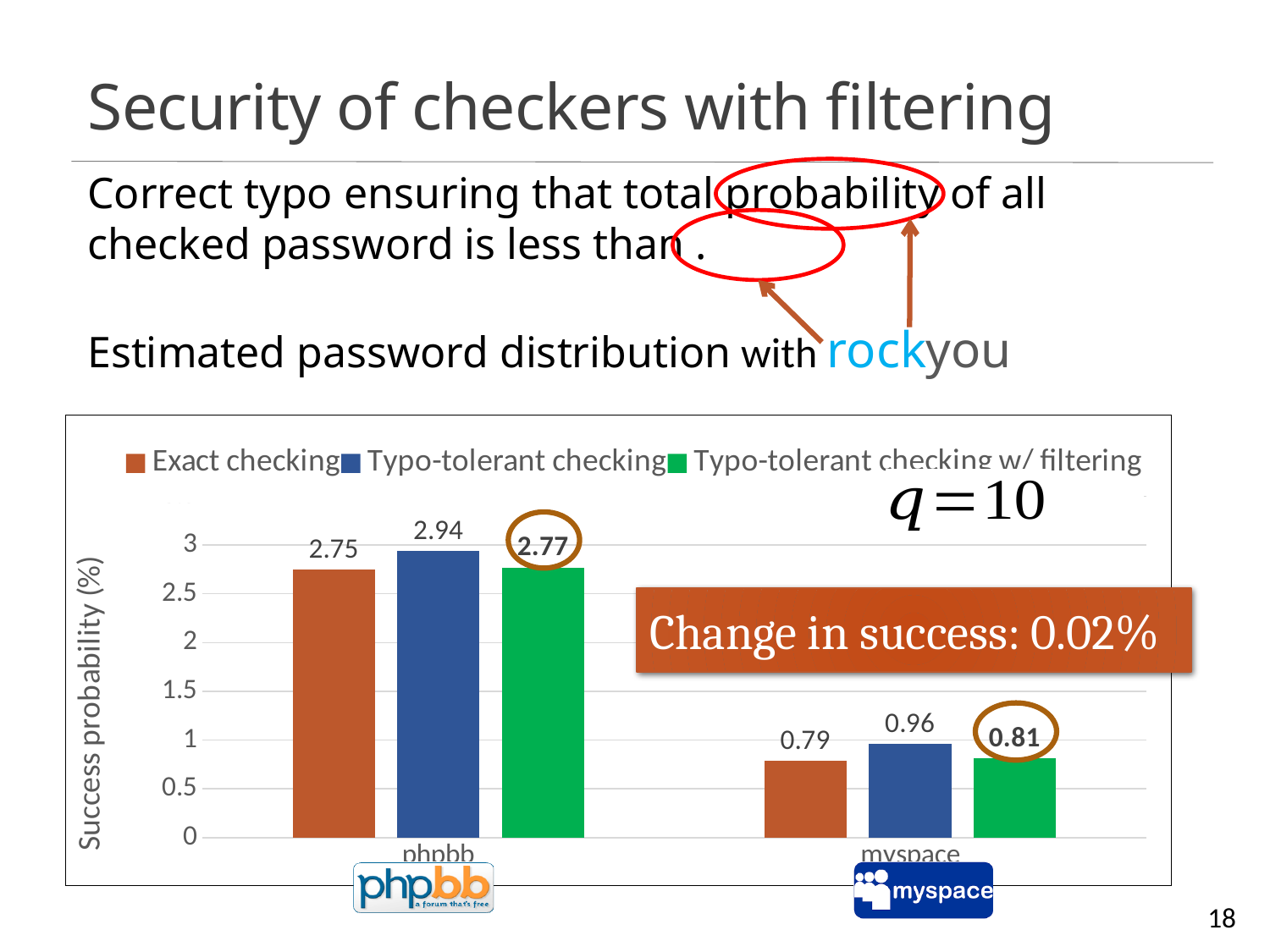
Which series has the lowest success probability for myspace? Exact checking How many categories are shown on the x axis? 2 What is the success probability for Exact checking on phpbb? 2.75 Which series has the highest success probability for phpbb? Typo-tolerant checking Which is larger: Typo-tolerant checking for phpbb or Typo-tolerant checking for myspace? Typo-tolerant checking for phpbb What is the success probability for Typo-tolerant checking on myspace? 0.96 What is the success probability for Typo-tolerant checking w/ filtering on phpbb? 2.77 What is the difference between Typo-tolerant checking and Exact checking for phpbb? 0.19 How many series does the legend list? 3 What kind of chart is shown on the slide? Bar chart What is the difference between Typo-tolerant checking w/ filtering and Exact checking for myspace? 0.02 What is the success probability for Typo-tolerant checking w/ filtering on myspace? 0.81